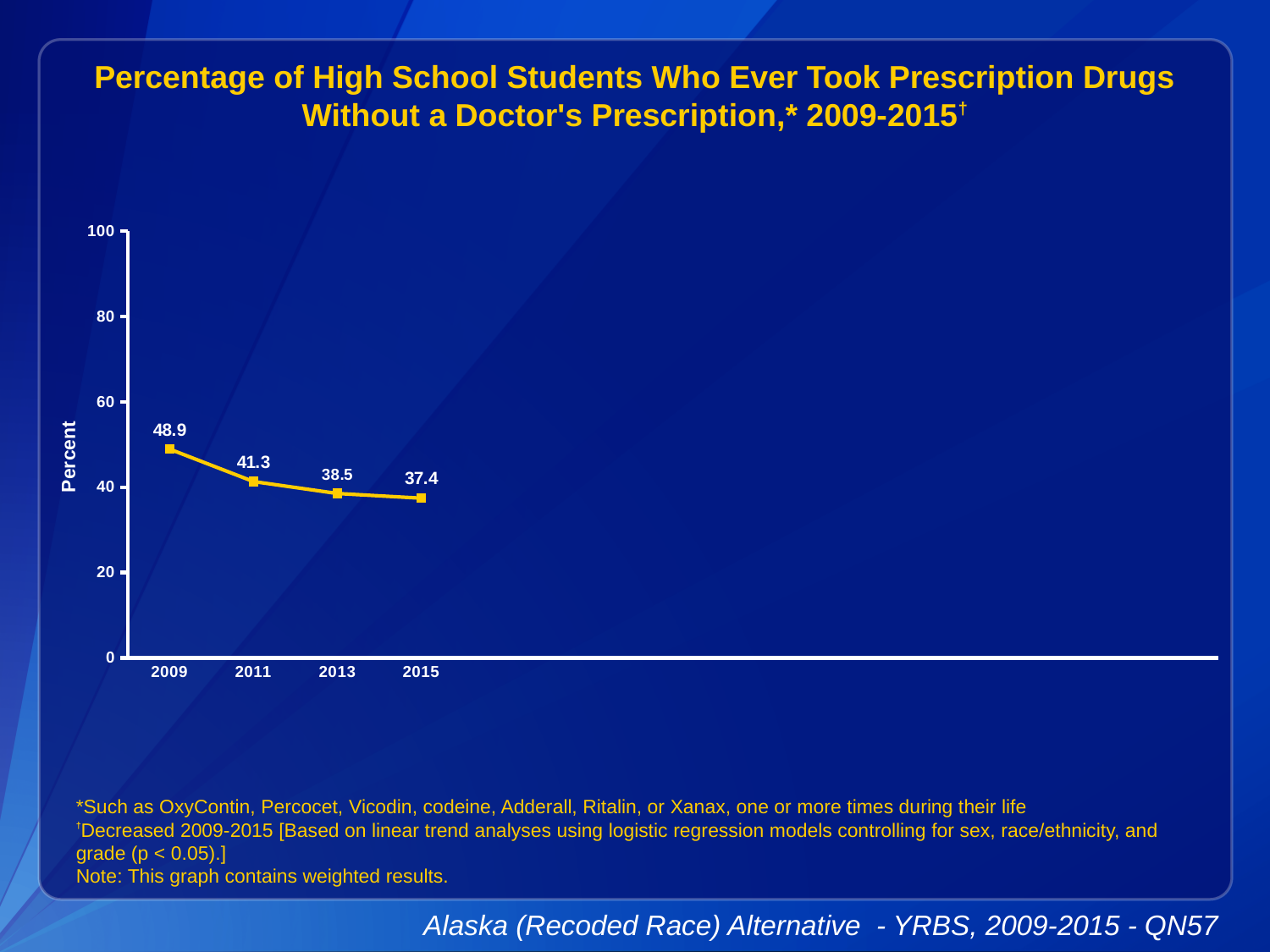
How many years are plotted on the chart? 4 Which year has the highest percentage? 2009 Do the values rise or fall from 2009 to 2015? fall Is the value for 2009 greater or less than 40? greater What is the difference between the 2009 value and the 2015 value? 11.5 Which year has the lowest percentage? 2015 What percentage of high school students reported ever taking prescription drugs without a doctor's prescription in 2009? 48.9 Which is larger, the value for 2011 or the value for 2013? 2011 What is the value plotted for 2011? 41.3 What kind of chart is shown on the slide? line chart What is the value plotted for 2015? 37.4 What is the value plotted for 2013? 38.5